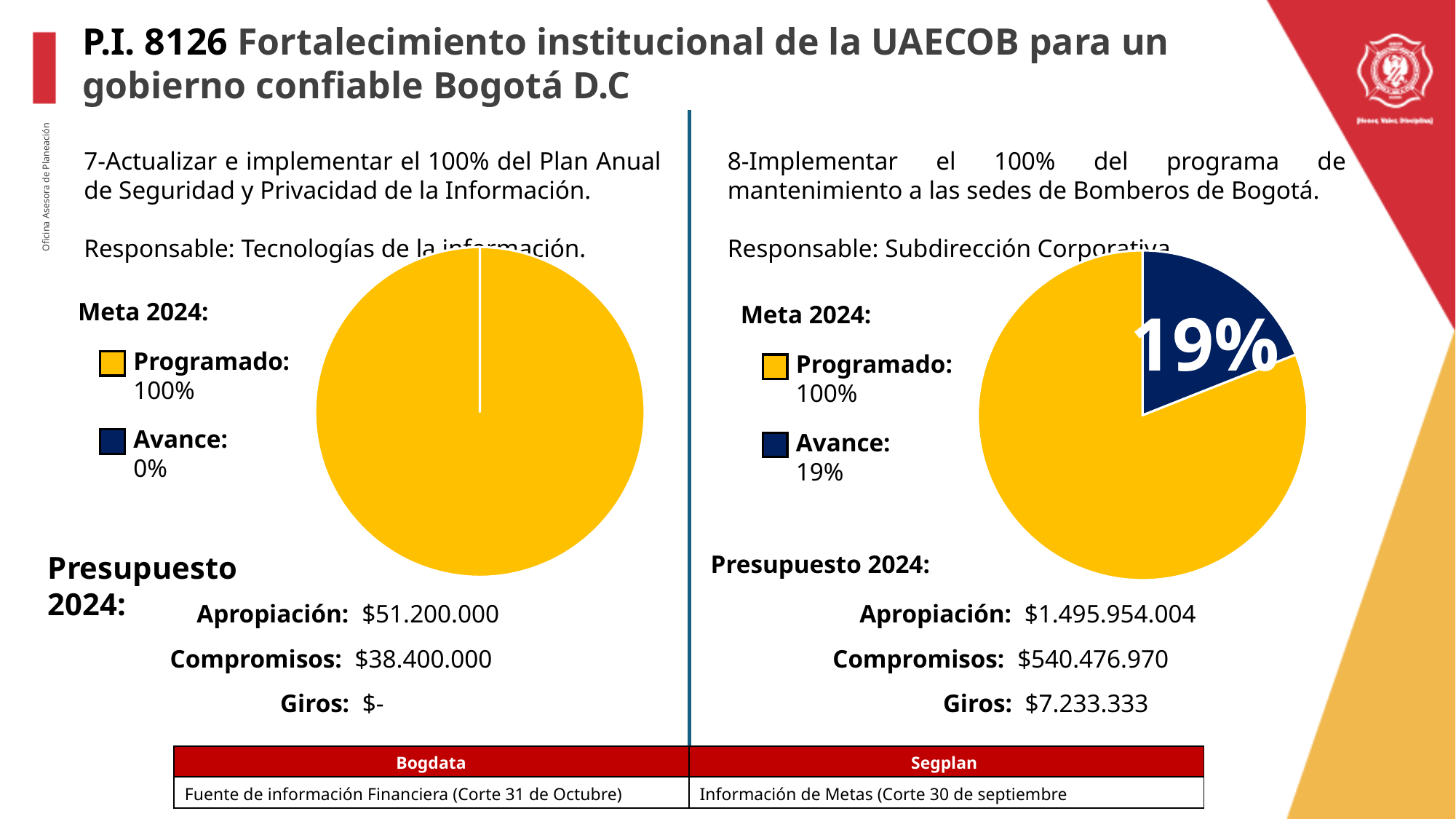
In the left-hand pie chart (goal 7), what colour represents Programado? yellow How many entries does the legend of the right-hand pie chart (goal 8) list? 2 In the right-hand pie chart (goal 8), what is the difference between Programado and Avance? 81% How many entries does the legend of the left-hand pie chart (goal 7) list? 2 What percentage is printed as a data label on the right-hand pie chart (goal 8)? 19% In the right-hand pie chart (goal 8), what is the value for Programado? 100% In the right-hand pie chart (goal 8), which is larger, Programado or Avance? Programado In the right-hand pie chart (goal 8), what colour represents Avance? dark blue What kind of chart is shown on the left side of the slide, under goal 7? pie chart In the left-hand pie chart (goal 7), what is the value for Programado? 100% In the right-hand pie chart (goal 8), what is the value for Avance? 19% In the left-hand pie chart (goal 7), what is the value for Avance? 0%